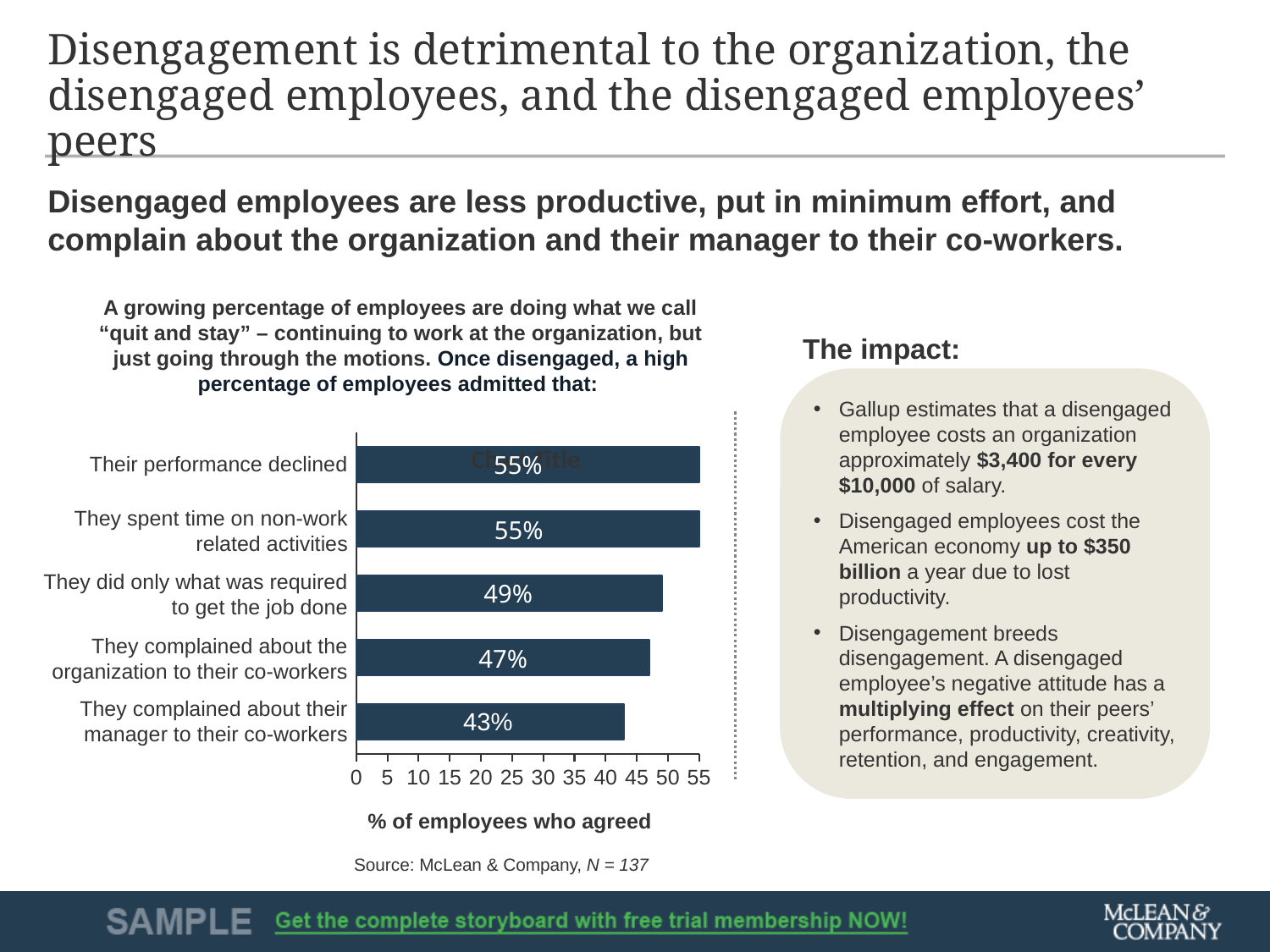
What kind of chart is shown on the slide? Bar chart What is the difference between the values for "They did only what was required to get the job done" and "They complained about the organization to their co-workers"? 2% Is the value for "They complained about the organization to their co-workers" greater or less than 50? less What percentage of employees agreed that they complained about the organization to their co-workers? 47% What is the label of the horizontal axis of the chart? % of employees who agreed Which is larger: the value for "They did only what was required to get the job done" or the value for "They complained about their manager to their co-workers"? They did only what was required to get the job done How many categories are shown in the chart? 5 What is the value for "They spent time on non-work related activities"? 55% What is the difference between the value for "Their performance declined" and the value for "They complained about their manager to their co-workers"? 12% What percentage of employees agreed that their performance declined? 55% Which category has the lowest value in the chart? They complained about their manager to their co-workers What is the value for "They did only what was required to get the job done"? 49%